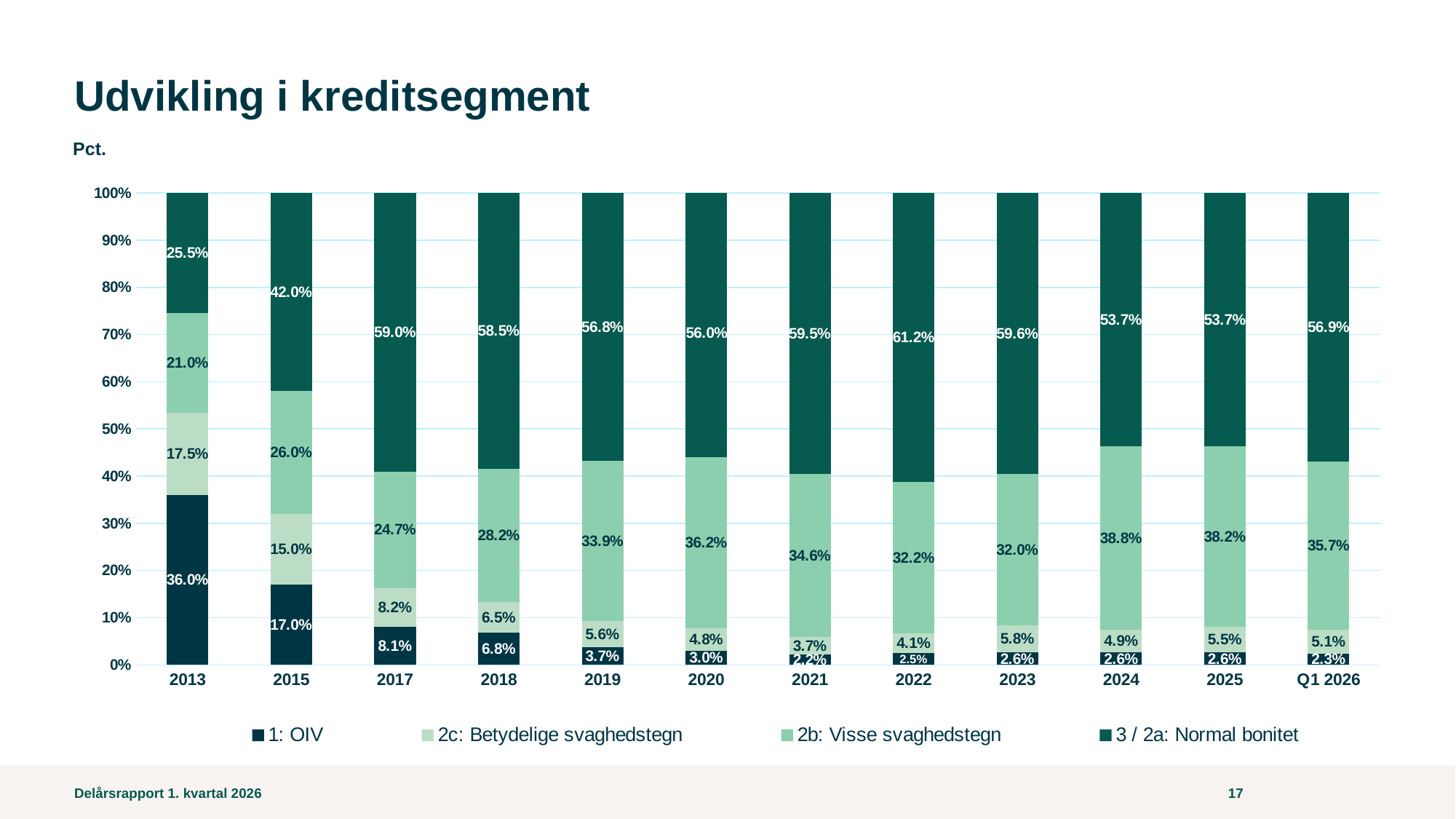
What is the value for 1: OIV in 2013? 36.0% How many periods are shown on the x axis? 12 By how many percentage points did the 1: OIV share fall from 2013 to Q1 2026? 33.7 percentage points Does the share of 1: OIV generally rise or fall from 2013 to Q1 2026? Fall How many series does the legend list? 4 What is the value for 2c: Betydelige svaghedstegn in 2017? 8.2% In which year is the share of 1: OIV lowest? 2021 What kind of chart is shown on the slide? Stacked bar chart What is the value for 2b: Visse svaghedstegn in 2024? 38.8% Which is larger, the 2b: Visse svaghedstegn share in 2020 or in 2021? 2020 In which year is the share of 3 / 2a: Normal bonitet highest? 2022 What is the value for 3 / 2a: Normal bonitet in Q1 2026? 56.9%